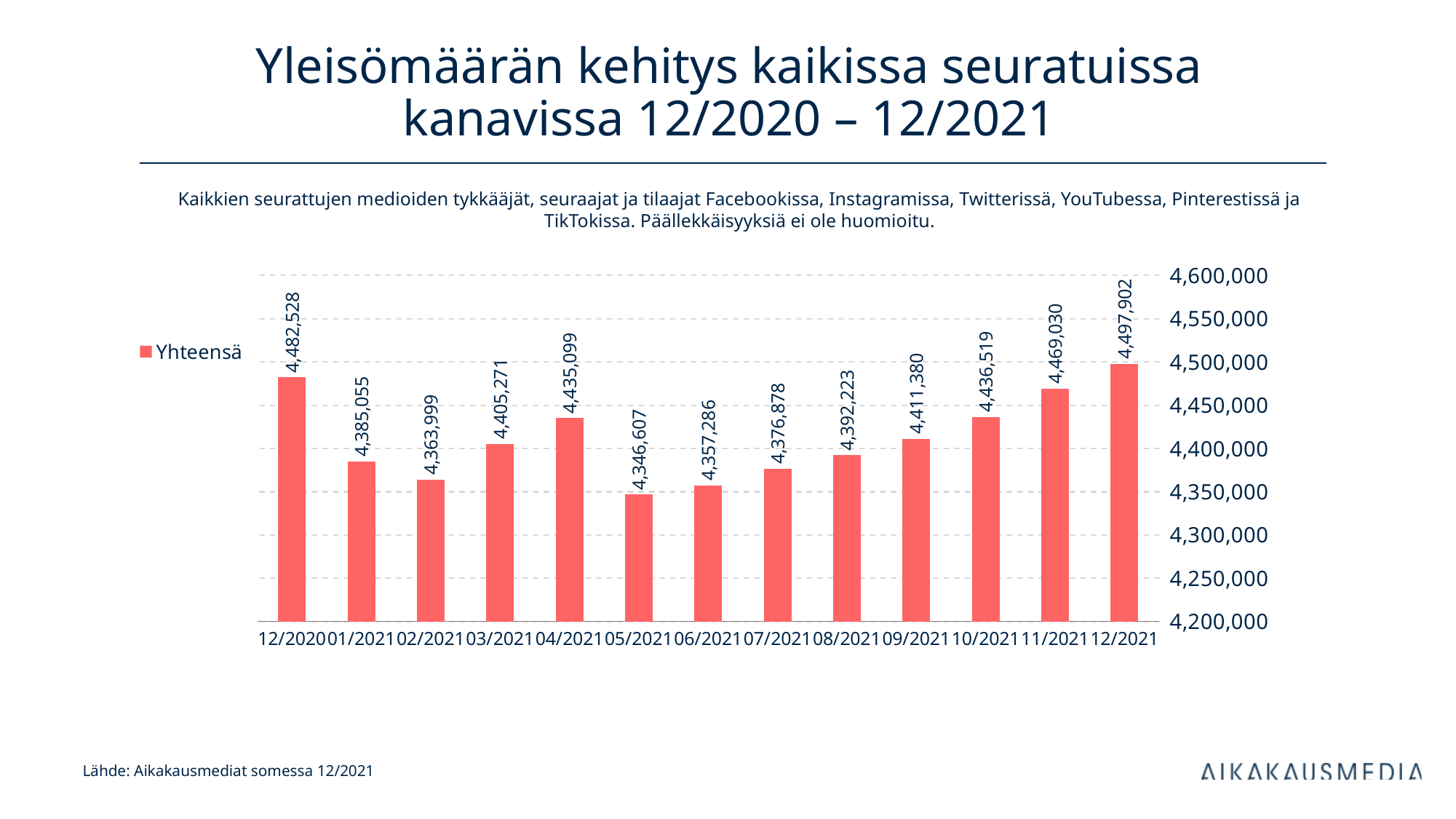
How many months are shown on the x axis? 13 Do the values rise or fall from 05/2021 to 12/2021? rise What is the difference between the values for 12/2021 and 12/2020? 15,374 Which month has the lowest value? 05/2021 Which is larger, the value for 03/2021 or the value for 08/2021? 03/2021 What is the value for 12/2020? 4,482,528 What is the value for 05/2021? 4,346,607 How many series does the legend list? 1 Is the value for 06/2021 greater or less than 4,400,000? less What is the difference between the values for 11/2021 and 10/2021? 32,511 Which month has the highest value? 12/2021 What is the value for 09/2021? 4,411,380